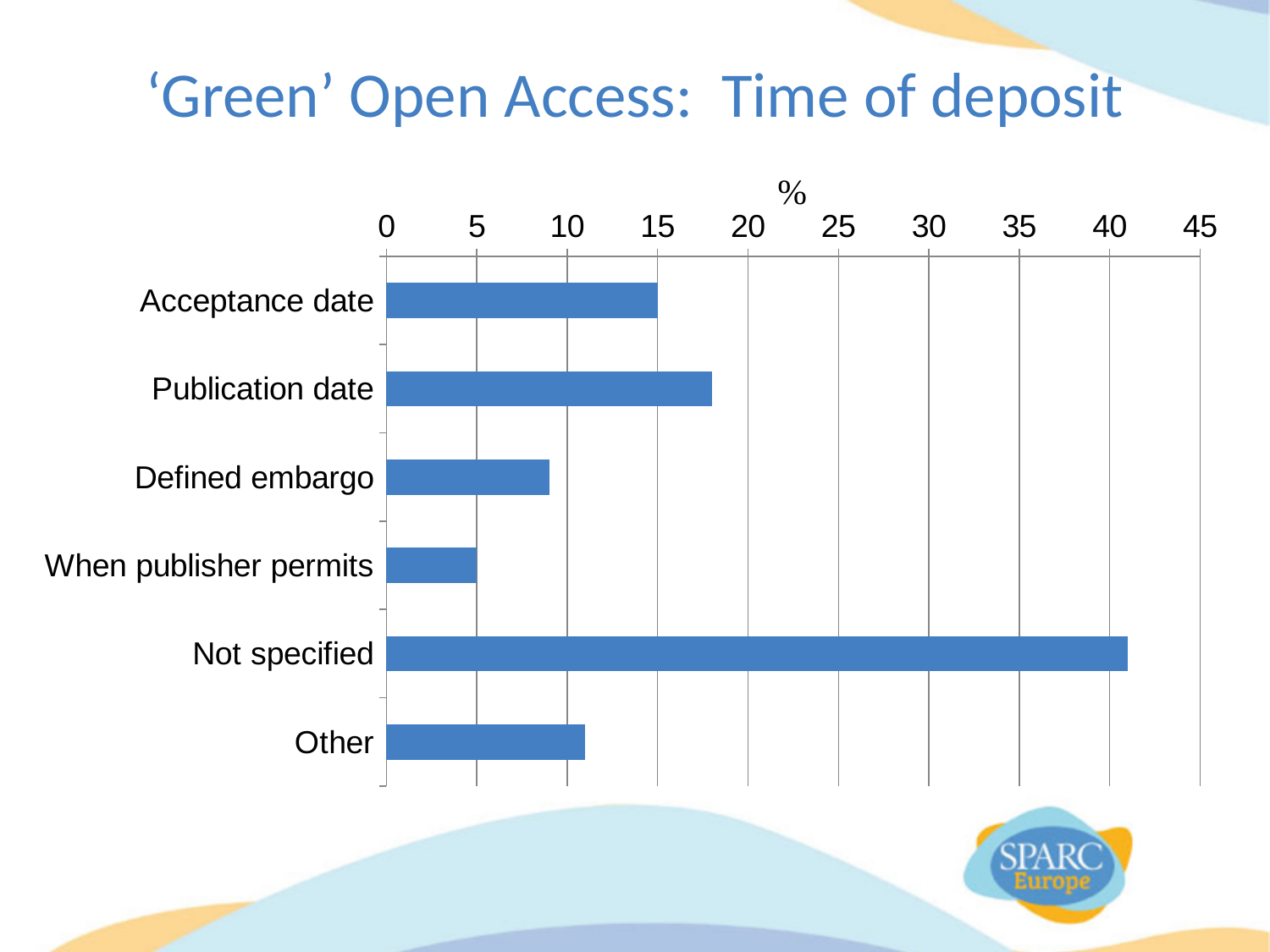
Which category has the lowest value? When publisher permits Which is larger, the value for Defined embargo or the value for Other? Other Is the value for Publication date greater or less than 20? less How many categories are shown on the chart? 6 Is the value for Other greater or less than 10? greater Is the value for Not specified greater or less than 40? greater Which category has the highest value? Not specified Which is larger, the value for Publication date or the value for Acceptance date? Publication date What kind of chart is shown on the slide? bar chart What unit is shown on the horizontal axis? % What is the title of the slide? 'Green' Open Access: Time of deposit